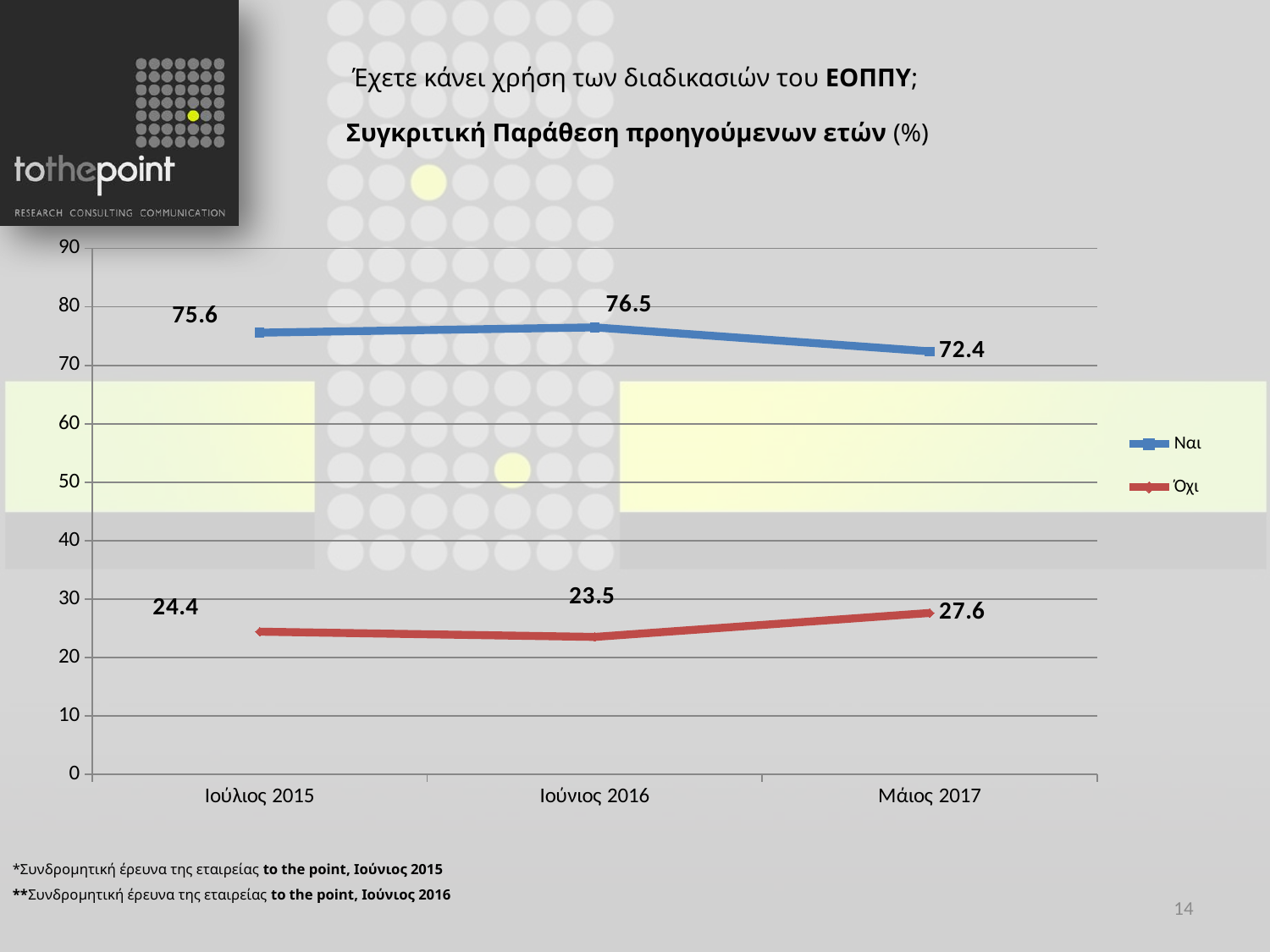
How many time periods are shown on the x axis? 3 Does the Όχι series rise or fall from Ιούνιος 2016 to Μάιος 2017? rise What kind of chart is shown? line chart What is the value for Όχι in Μάιος 2017? 27.6 In which period is the Όχι series lowest? Ιούνιος 2016 How many series does the legend list? 2 Is the value for Όχι in Ιούνιος 2016 greater or less than 30? less In which period is the Ναι series highest? Ιούνιος 2016 Which is larger in Ιούλιος 2015, Ναι or Όχι? Ναι What is the value for Ναι in Ιούλιος 2015? 75.6 What is the value for Ναι in Ιούνιος 2016? 76.5 What is the difference between Ναι and Όχι in Μάιος 2017? 44.8